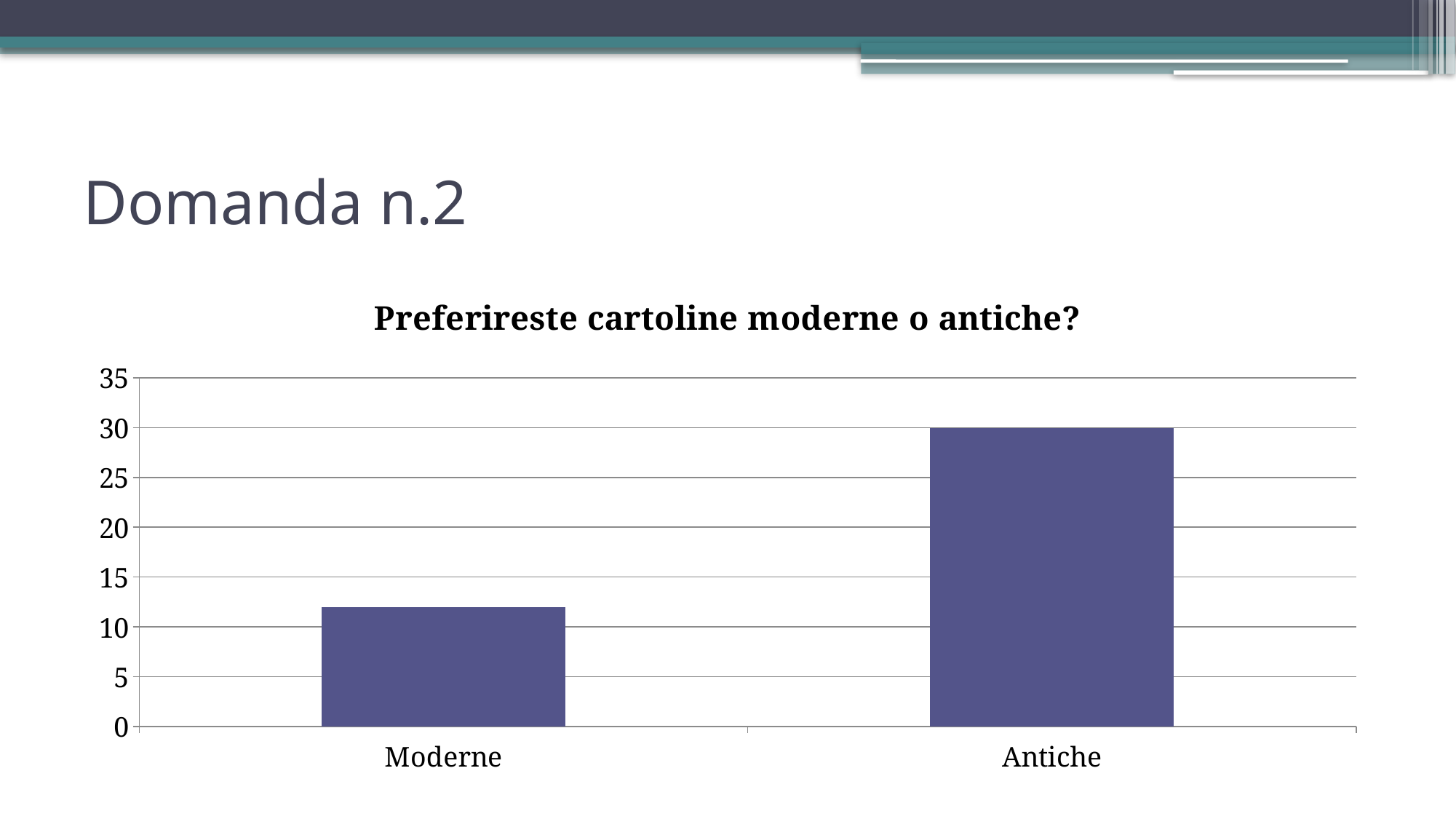
Which is larger, the value for Moderne or the value for Antiche? Antiche How many categories are shown on the x axis of the chart? 2 Which category has the highest value in the chart? Antiche Is the value for Moderne greater or less than 10? greater Which category has the lowest value in the chart? Moderne What is the value for Antiche? 30 What kind of chart is shown on the slide? bar chart Is the value for Moderne greater or less than 15? less What is the title of the chart? Preferireste cartoline moderne o antiche? Do the values rise or fall from Moderne to Antiche along the x axis? rise What is the highest value shown on the vertical axis of the chart? 35 Is the value for Antiche greater or less than 25? greater